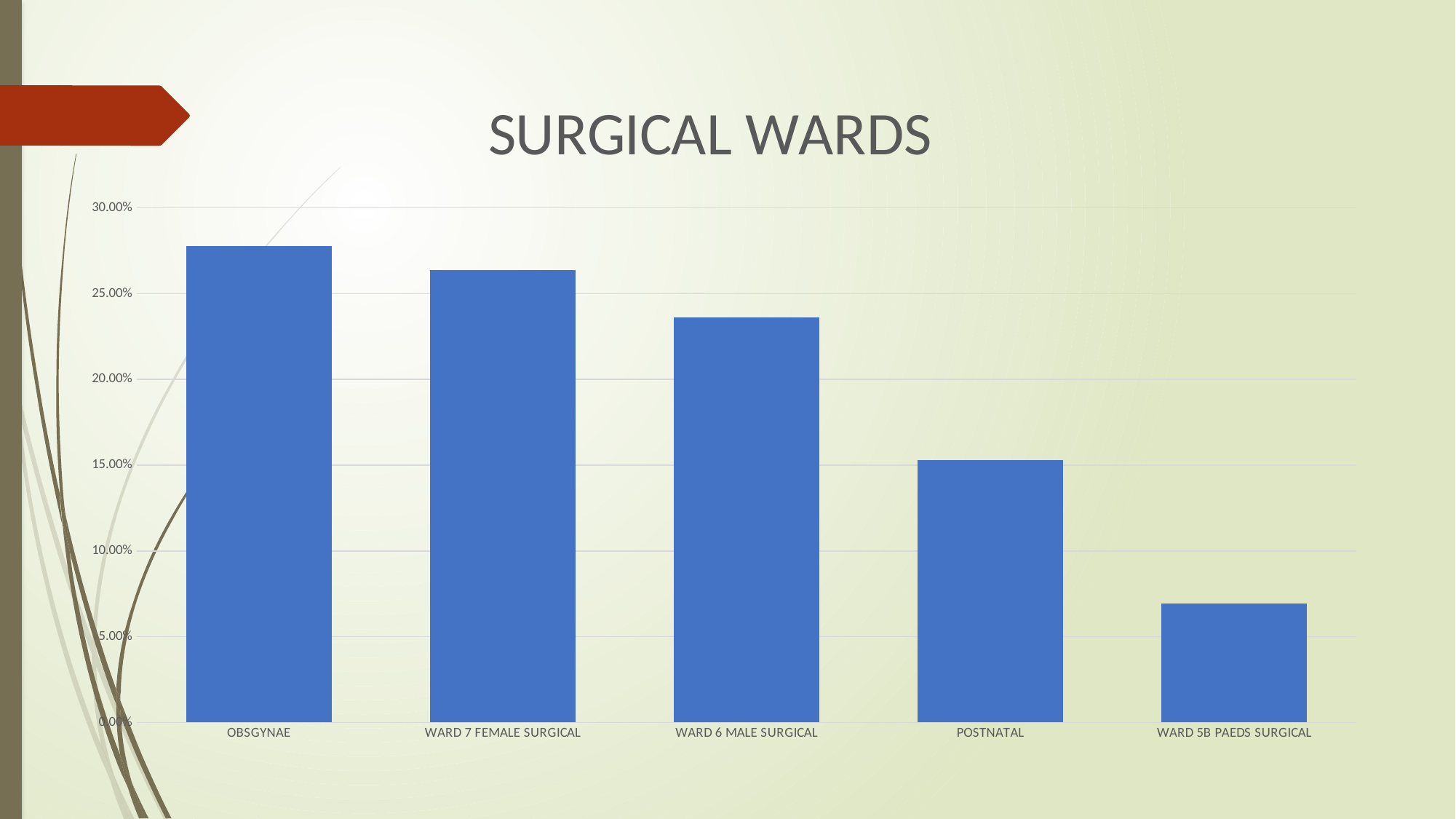
Is the value for WARD 6 MALE SURGICAL greater or less than 25.00%? less Is the value for OBSGYNAE greater or less than 25.00%? greater How many wards (categories) are plotted in the chart? 5 What kind of chart is shown on the slide? bar chart Which ward has the highest value? OBSGYNAE Which ward has the lowest value? WARD 5B PAEDS SURGICAL Do the values rise or fall moving from left to right across the categories? fall Is the value for POSTNATAL greater or less than 20.00%? less What is the highest value shown on the vertical axis? 30.00% What is the title of the chart? SURGICAL WARDS Which is larger, the value for WARD 7 FEMALE SURGICAL or the value for POSTNATAL? WARD 7 FEMALE SURGICAL